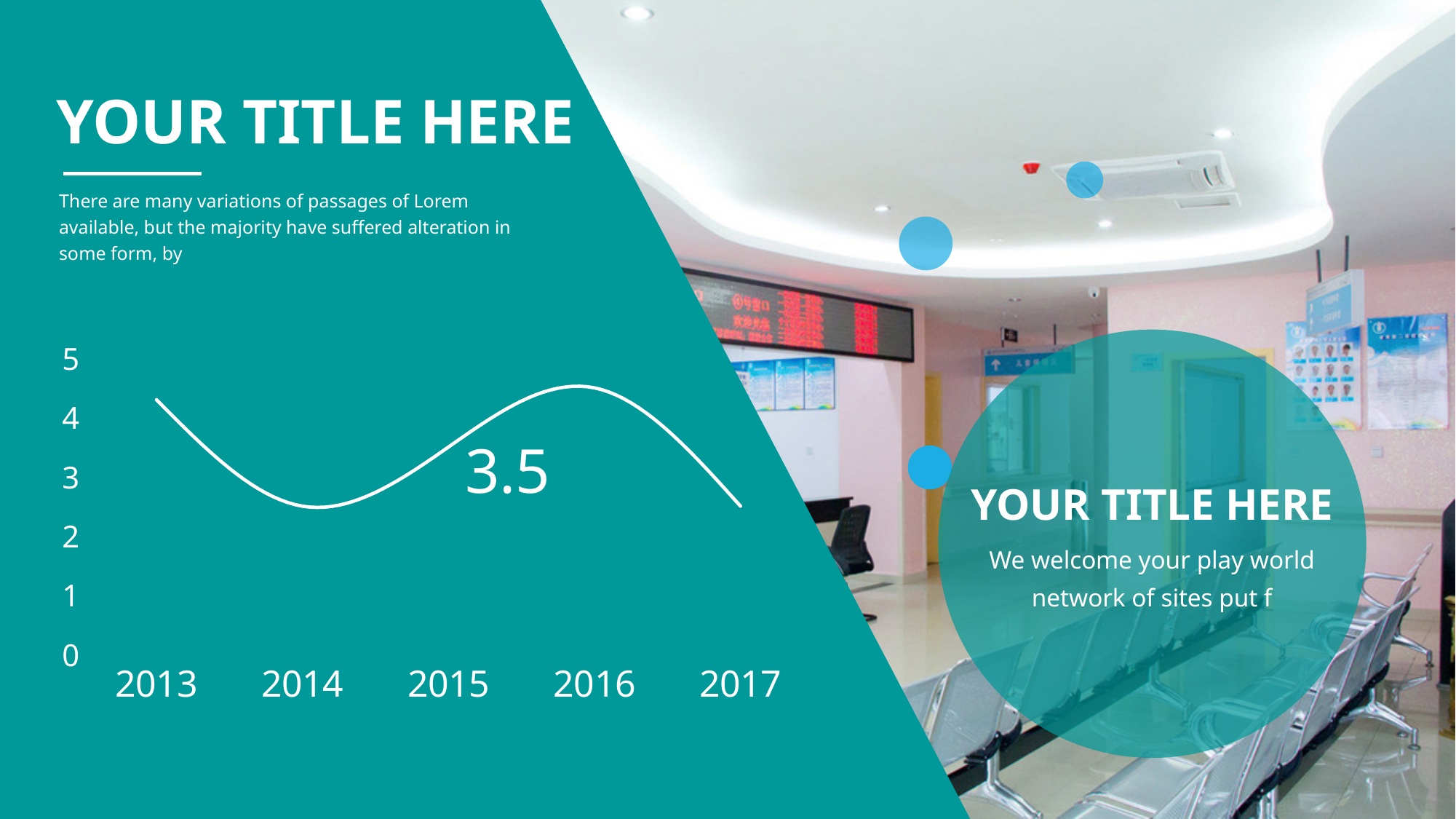
Is the value for 2017 greater or less than 3? less Is the value for 2016 greater or less than 4? greater Does the line rise or fall from 2013 to 2014? fall What is the highest value shown on the y axis of the chart? 5 Is the value for 2013 greater or less than 3? greater What kind of chart is shown on the slide? line chart How many years are shown on the x axis of the chart? 5 Which year has the highest value on the chart? 2016 Does the line rise or fall from 2014 to 2016? rise Which is larger, the value for 2013 or the value for 2014? 2013 What value is labelled on the chart for 2015? 3.5